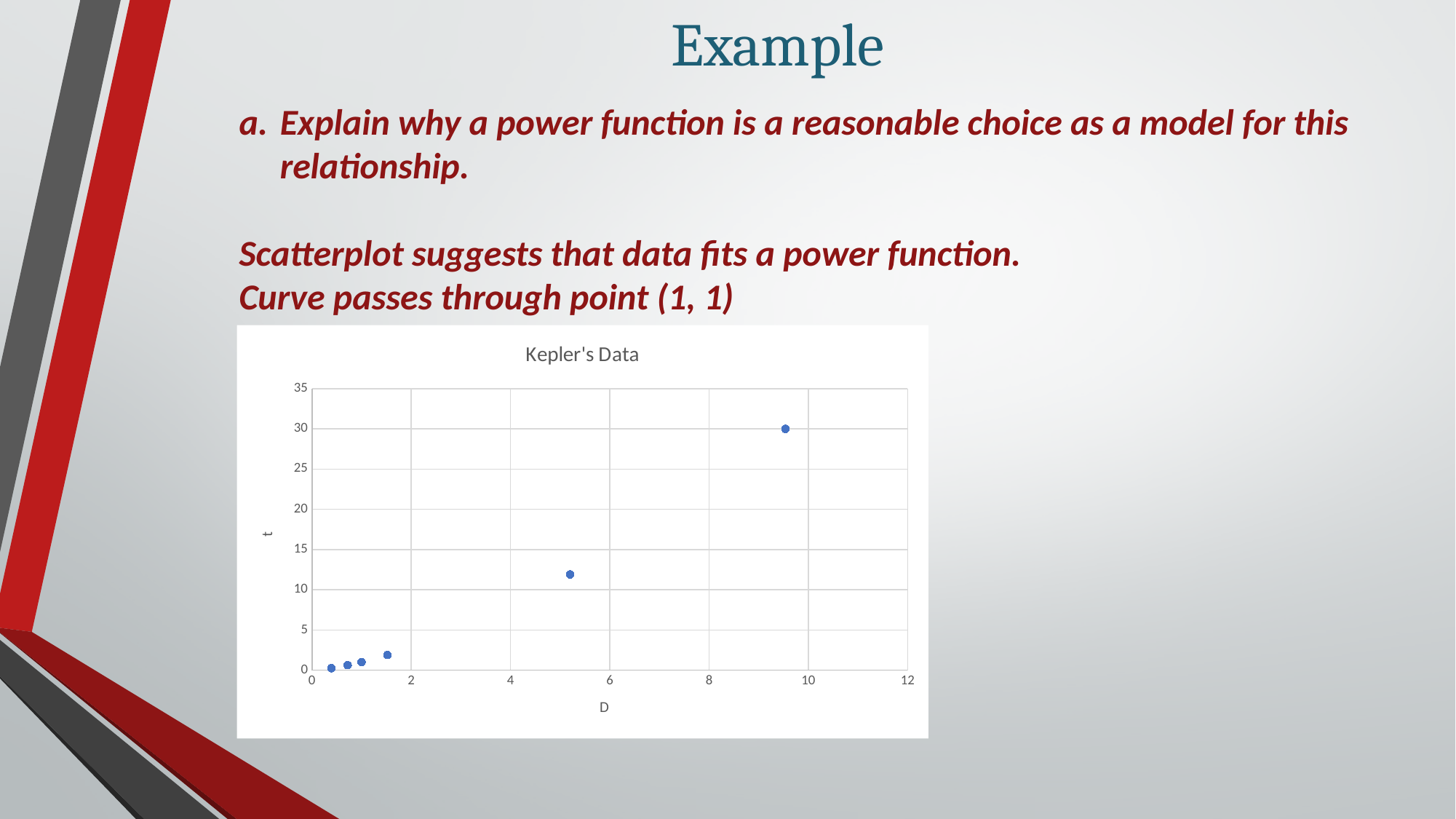
Is the t value of the point plotted near D = 5 greater or less than 10? greater What is the title of the chart? Kepler's Data Is the t value of the point plotted near D = 5 greater or less than 15? less Is the t value of the point plotted near D = 10 greater or less than 25? greater What is the label on the horizontal axis of the chart? D What is the highest value shown on the vertical axis of the chart? 35 How many data points are plotted in the chart? 6 Do the t values rise or fall as D increases along the x axis? rise Which point has the larger t value: the one plotted near D = 5 or the one plotted near D = 10? the one near D = 10 What kind of chart is shown on the slide? scatter plot